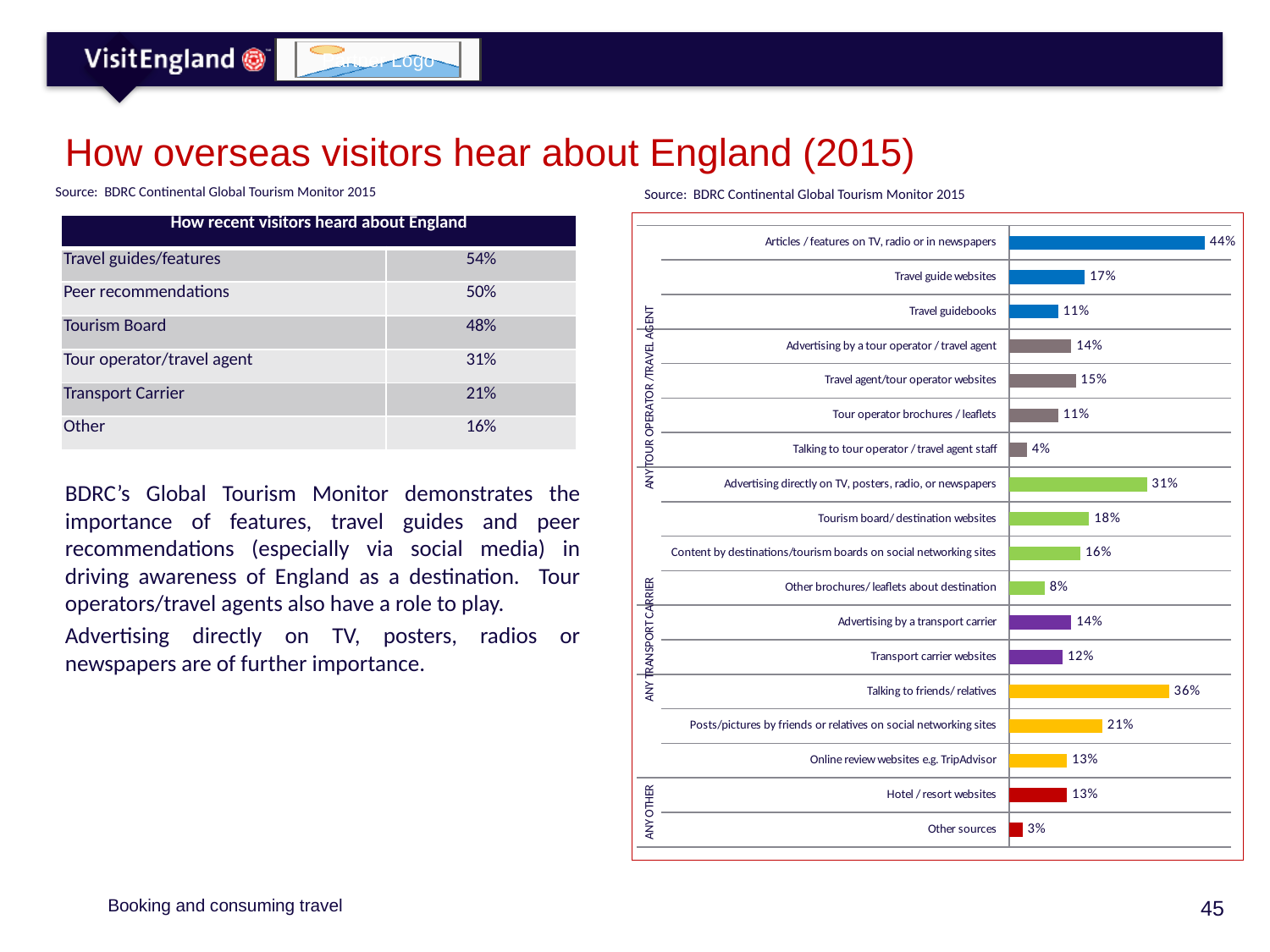
What is the value for Articles / features on TV, radio or in newspapers? 44% What is the value for Tourism board/ destination websites? 18% Which category has the lowest value in the chart? Other sources What is the value for Transport carrier websites? 12% What kind of chart is shown on the slide? Bar chart Which is larger: Travel agent/tour operator websites or Travel guidebooks? Travel agent/tour operator websites What source is cited above the chart? BDRC Continental Global Tourism Monitor 2015 How many categories are plotted in the chart? 18 Which category has the highest value in the chart? Articles / features on TV, radio or in newspapers What is the value for Talking to friends/ relatives? 36% What is the difference between Talking to friends/ relatives and Posts/pictures by friends or relatives on social networking sites? 15% What is the difference between Advertising directly on TV, posters, radio, or newspapers and Travel guide websites? 14%